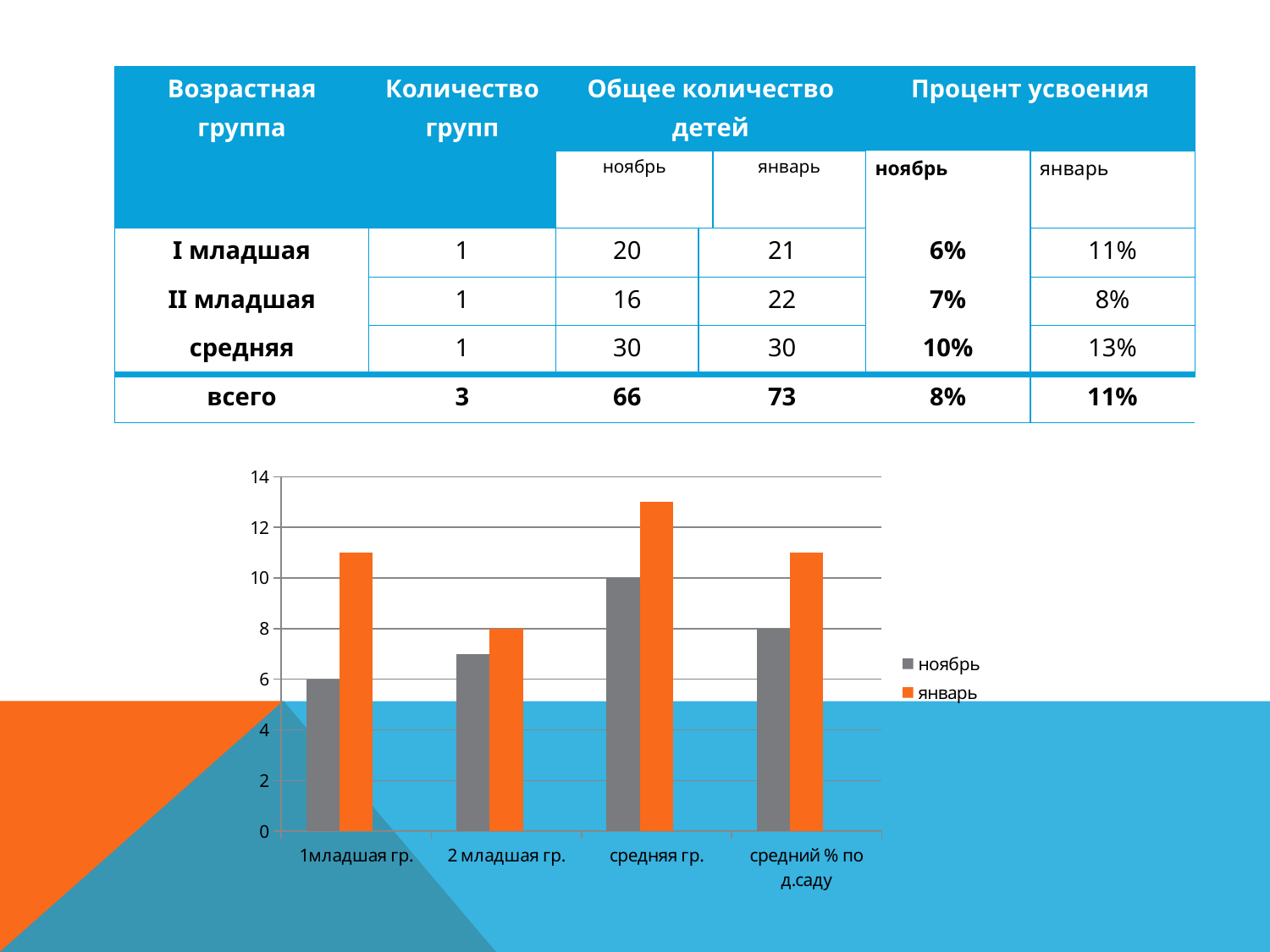
What is the value of the ноябрь bar for средняя гр.? 10 What is the difference between the ноябрь values for средняя гр. and 1младшая гр.? 4 Which category has the lowest ноябрь bar? 1младшая гр. Which category has the highest январь bar? средняя гр. Is the январь value for средняя гр. greater or less than 12? greater What is the value of the январь bar for 2 младшая гр.? 8 What is the value of the ноябрь bar for 1младшая гр.? 6 What type of chart is shown on the slide? bar chart For средняя гр., which series has the larger bar, ноябрь or январь? январь How many series does the chart legend list? 2 What is the value of the ноябрь bar for средний % по д.саду? 8 How many categories are shown on the x axis of the chart? 4